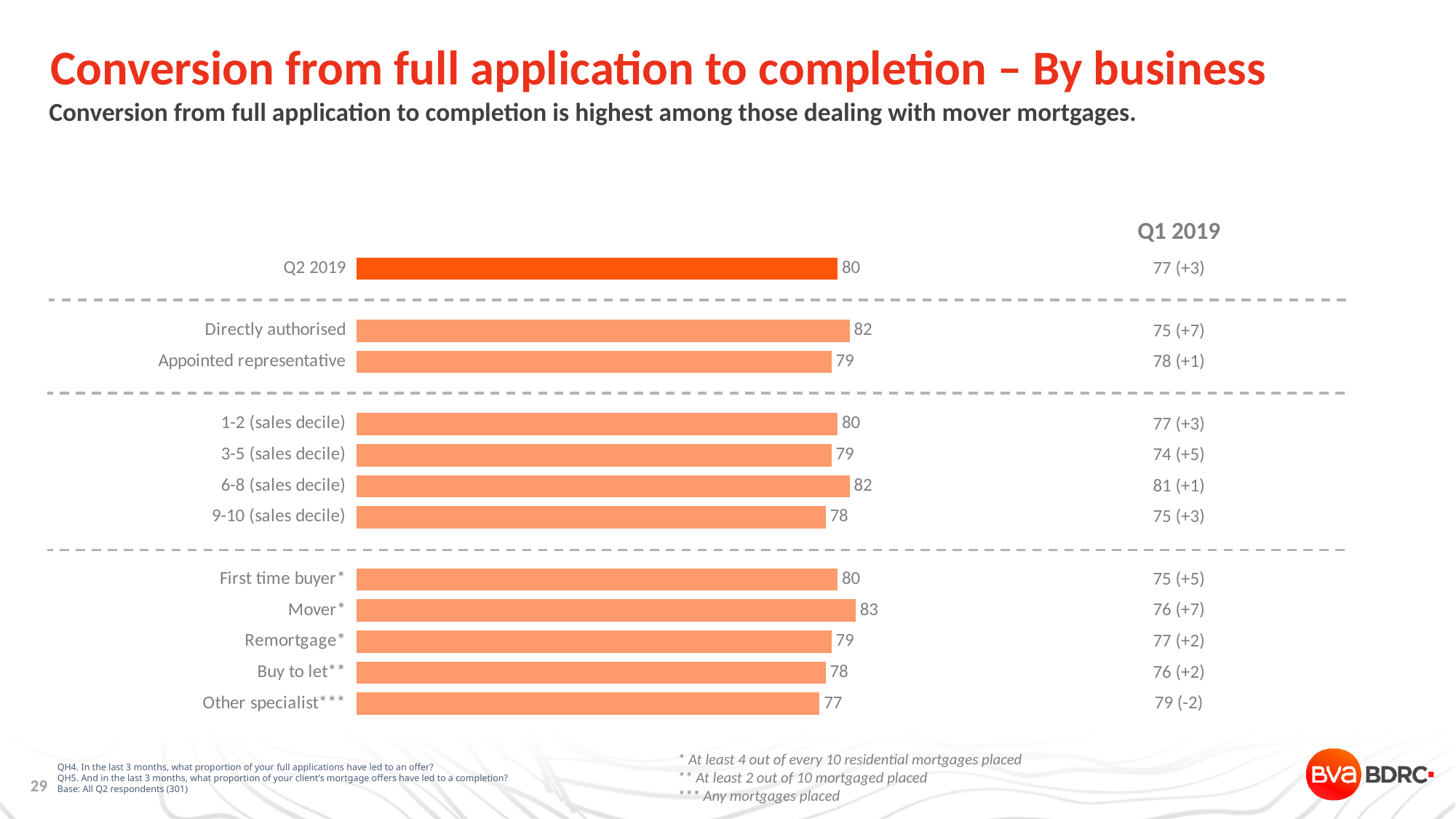
What is the difference between the values for Mover and Other specialist? 6 What is the value for Mover? 83 Which is larger, the value for 6-8 (sales decile) or 3-5 (sales decile)? 6-8 (sales decile) What is the value for 9-10 (sales decile)? 78 Which category has the lowest value? Other specialist What is the Q1 2019 value shown for Directly authorised? 75 (+7) How many bars are plotted on the chart? 12 What kind of chart is shown? Bar chart What is the value for Q2 2019 overall? 80 What is the difference between the values for Directly authorised and Appointed representative? 3 What is the value for Appointed representative? 79 Which category has the highest value? Mover